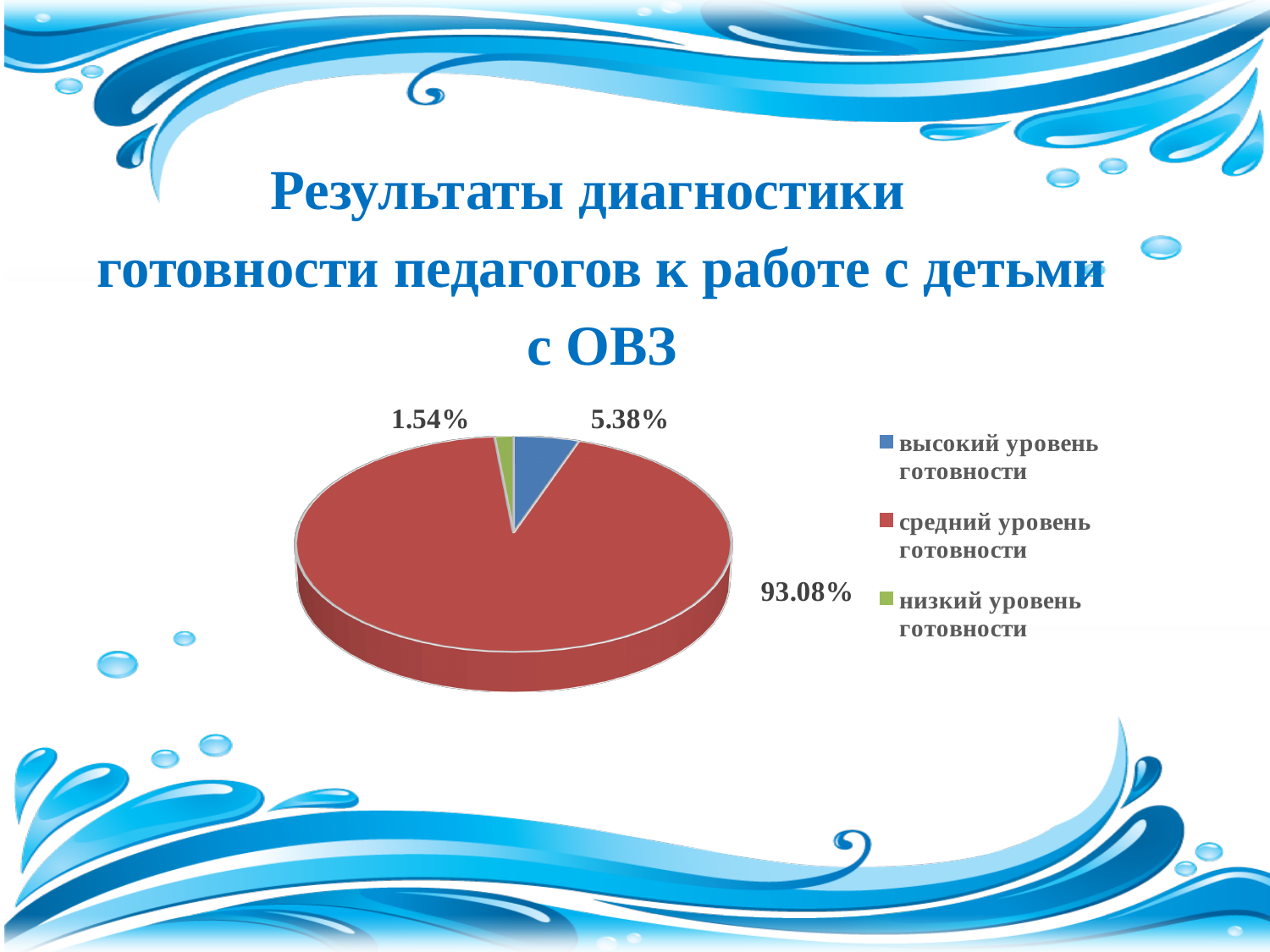
What kind of chart is shown on the slide? pie chart Which category has the smallest slice of the pie? низкий уровень готовности Which is larger: the высокий уровень готовности slice or the низкий уровень готовности slice? высокий уровень готовности What is the difference in percentage points between the высокий уровень готовности slice and the низкий уровень готовности slice? 3.84 What share of the pie is labelled for the средний уровень готовности slice? 93.08% What colour is the средний уровень готовности slice in the pie chart? red What is the difference in percentage points between the средний уровень готовности slice and the высокий уровень готовности slice? 87.70 What share of the pie is labelled for the низкий уровень готовности slice? 1.54% How many entries does the legend list? 3 How many slices does the pie chart have? 3 What share of the pie is labelled for the высокий уровень готовности slice? 5.38% Which category has the largest slice of the pie? средний уровень готовности